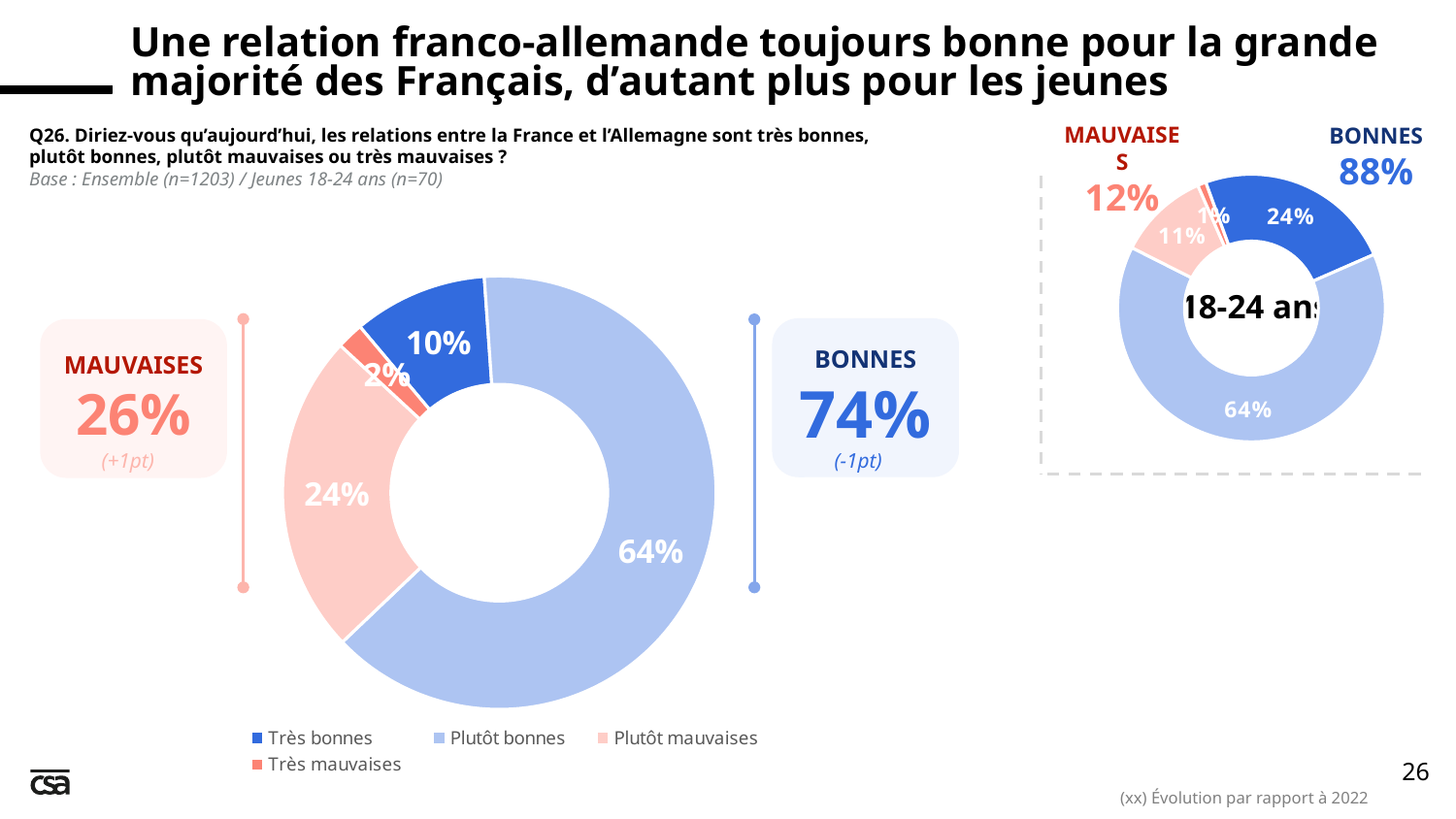
In the large donut chart for the whole sample, what share of respondents answered "Très mauvaises"? 2% In the large donut chart for the whole sample, what share of respondents answered "Plutôt bonnes"? 64% In the small 18-24 ans donut chart, what share of respondents answered "Plutôt mauvaises"? 11% In the large donut chart for the whole sample, which response category has the largest share? Plutôt bonnes How many entries does the legend below the large donut chart list? 4 In the large donut chart for the whole sample, what share of respondents answered "Très bonnes"? 10% In the large donut chart for the whole sample, what is the difference between the "Plutôt bonnes" share and the "Plutôt mauvaises" share? 40 points In the small 18-24 ans donut chart, what share of respondents answered "Très bonnes"? 24% In the large donut chart for the whole sample, what share of respondents answered "Plutôt mauvaises"? 24% In the large donut chart for the whole sample, which response category has the smallest share? Très mauvaises Which is larger: the "Très bonnes" share in the large whole-sample chart or the "Très bonnes" share in the small 18-24 ans chart? 18-24 ans chart What type of chart is used to show the responses on this slide? Donut (pie) chart